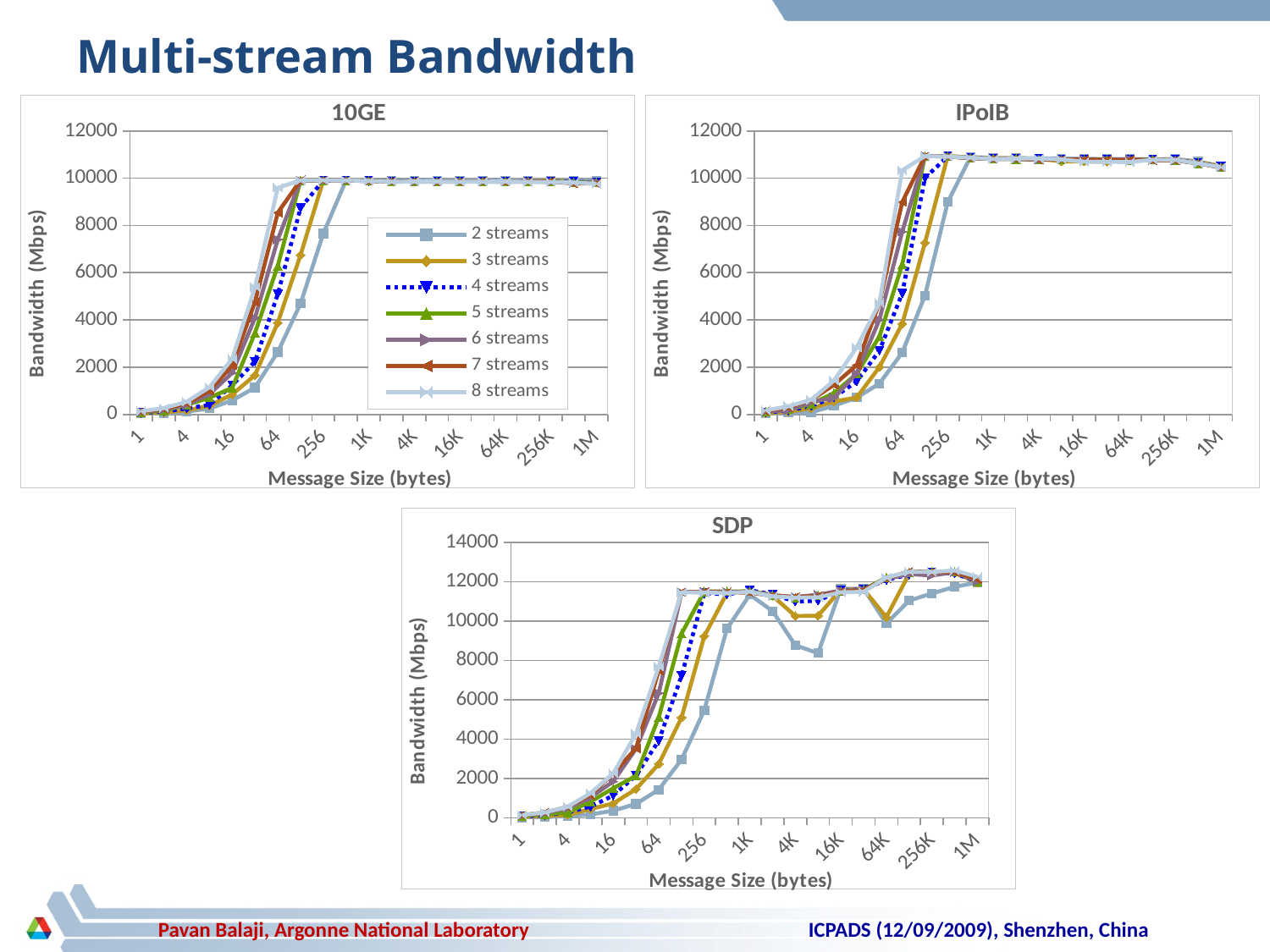
What is the title of the chart at the bottom of the slide? SDP What is the y-axis label on the IPoIB chart? Bandwidth (Mbps) On the 10GE chart, is the value for 2 streams at message size 1M greater or less than 8000? greater On the IPoIB chart, is the value for 2 streams at message size 64 greater or less than 2000? greater How many series does the legend on the 10GE chart list? 7 On the SDP chart, is the value for 2 streams at message size 1M greater or less than 10000? greater On the 10GE chart, does the 2 streams line rise or fall as message size increases from 1 to 256 bytes? rise On the 10GE chart, at message size 64, which is larger: 2 streams or 8 streams? 8 streams On the SDP chart, at message size 8K, which is larger: 2 streams or 3 streams? 3 streams What kind of chart is the 10GE chart? line chart